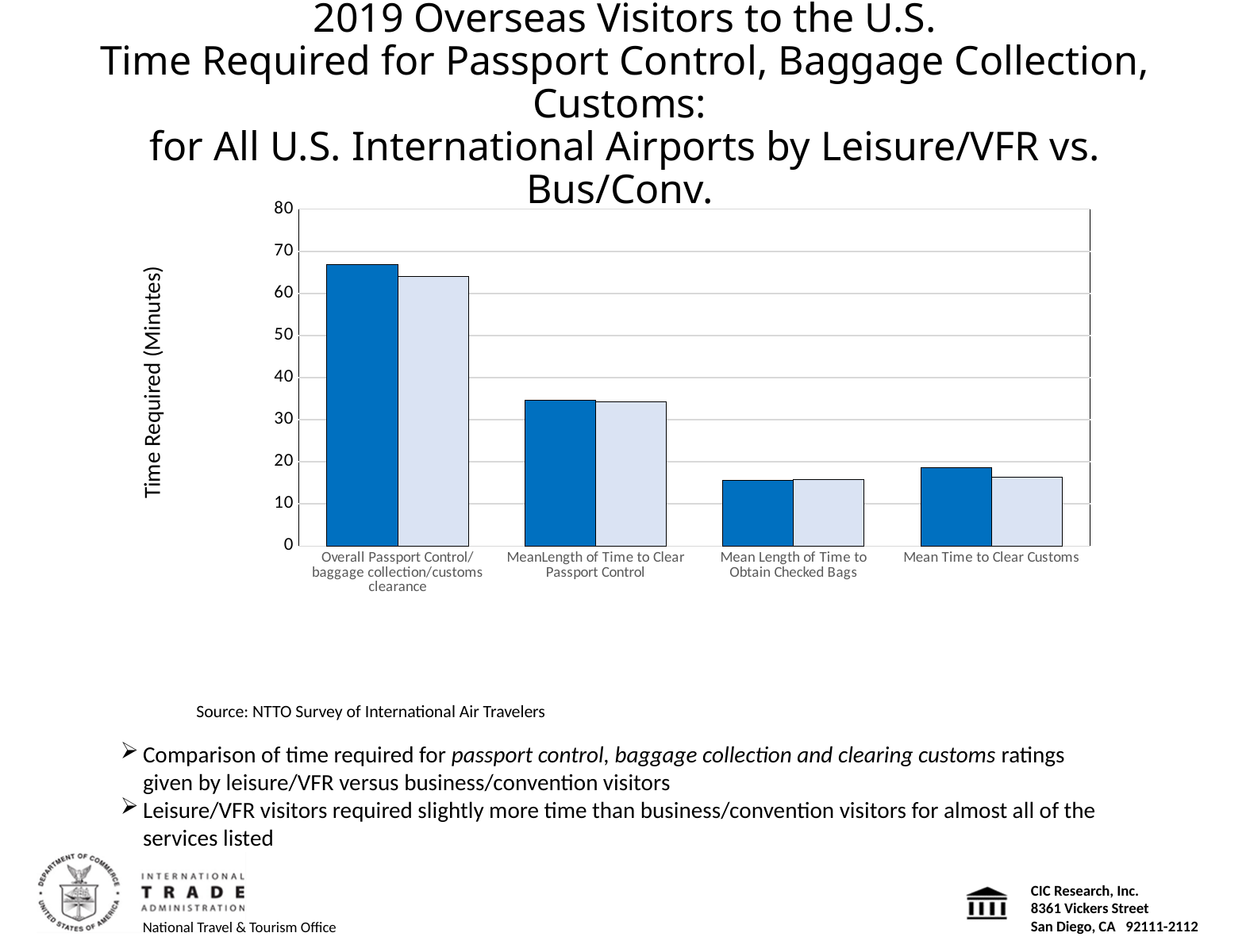
What kind of chart is shown on the slide? Bar chart Do the dark blue bars rise or fall from the first category to the third category along the x axis? Fall Is the dark blue bar for Overall Passport Control/baggage collection/customs clearance greater or less than 60? greater What is the title of the vertical axis of the chart? Time Required (Minutes) Among the dark blue bars, which category has the lowest value? Mean Length of Time to Obtain Checked Bags Is the light blue bar for Mean Time to Clear Customs greater or less than 20? less Is the light blue bar for Mean Length of Time to Obtain Checked Bags greater or less than 20? less For Mean Time to Clear Customs, which bar is taller, the dark blue or the light blue one? Dark blue How many categories are shown along the x axis of the chart? 4 How many bars are plotted for each category in the chart? 2 Which category has the tallest bars in the chart? Overall Passport Control/baggage collection/customs clearance